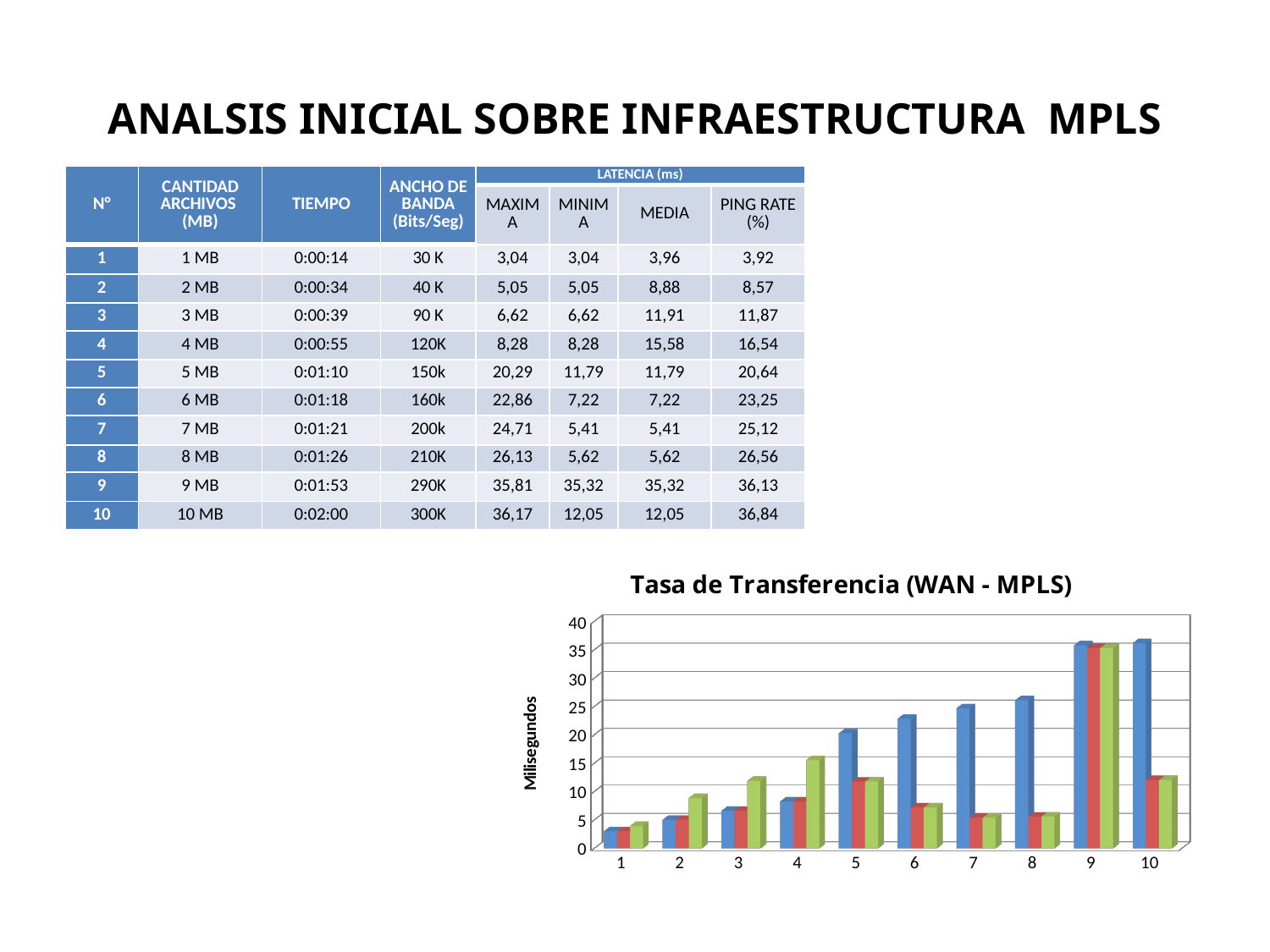
How many categories are shown along the x axis of the chart? 10 What is the title of the chart? Tasa de Transferencia (WAN - MPLS) Do the blue bars generally rise or fall from category 1 to category 10? rise How many bars are plotted for each category in the chart? 3 Which category has the shortest blue bar? 1 What kind of chart is shown on the slide? bar chart Is the red bar for category 7 greater or less than 10? less What is the label on the vertical axis of the chart? Milisegundos Is the blue bar for category 1 greater or less than 5? less Is the blue bar for category 9 greater or less than 30? greater Which category has the tallest green bar? 9